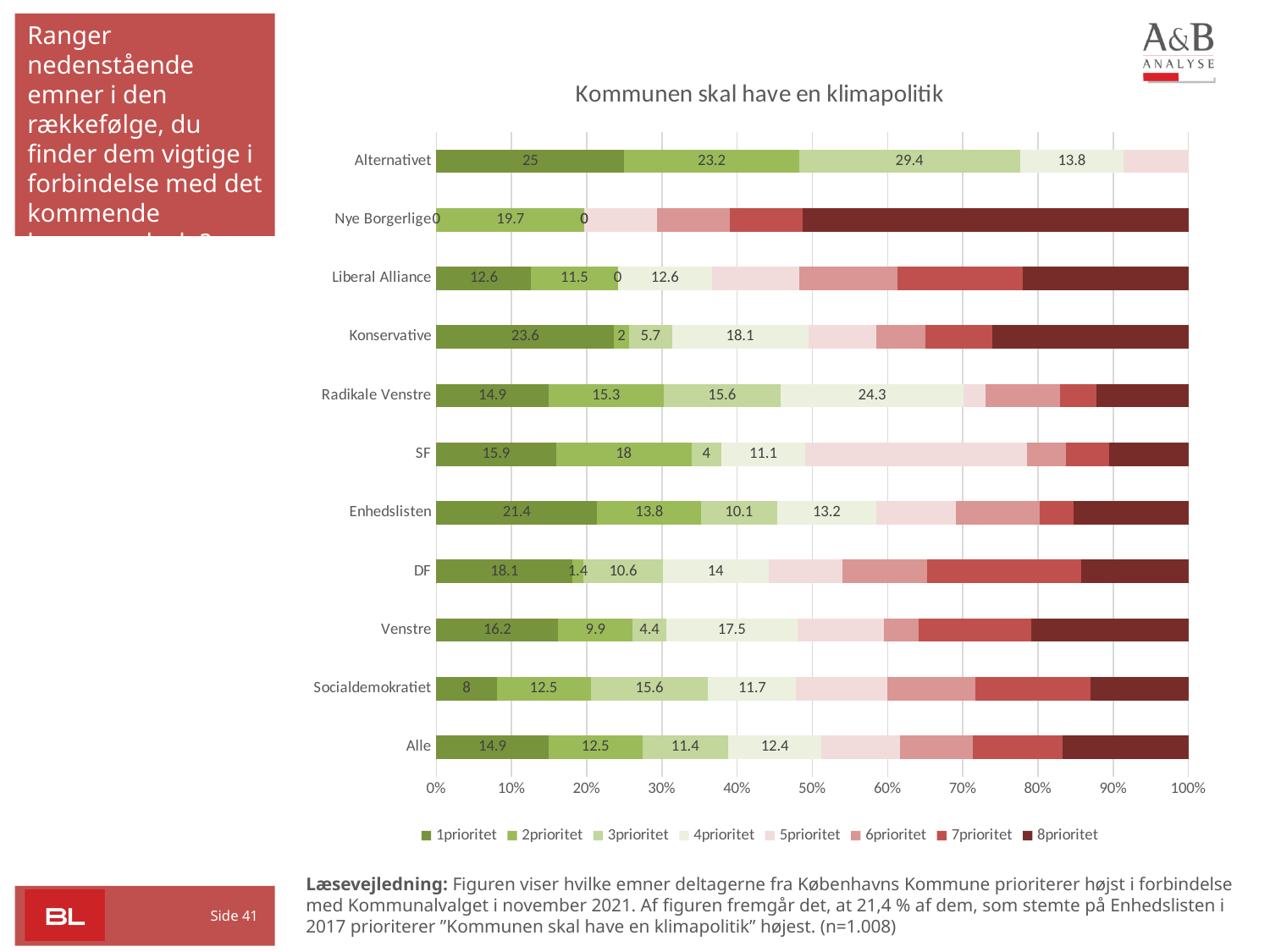
Which category has the lowest 1prioritet value? Nye Borgerlige What is the title of the chart? Kommunen skal have en klimapolitik What is the 2prioritet value for Nye Borgerlige? 19.7 What kind of chart is shown on the slide? Stacked bar chart What is the 4prioritet value for Radikale Venstre? 24.3 How many categories (parties/groups) are shown on the vertical axis of the chart? 11 What is the difference between the 1prioritet values for Konservative and Socialdemokratiet? 15.6 What is the 1prioritet value for Enhedslisten? 21.4 Which category has the highest 1prioritet value? Alternativet How many series does the chart legend list? 8 What is the 3prioritet value for Alternativet? 29.4 Which is larger: the 2prioritet value for SF or the 2prioritet value for Venstre? SF